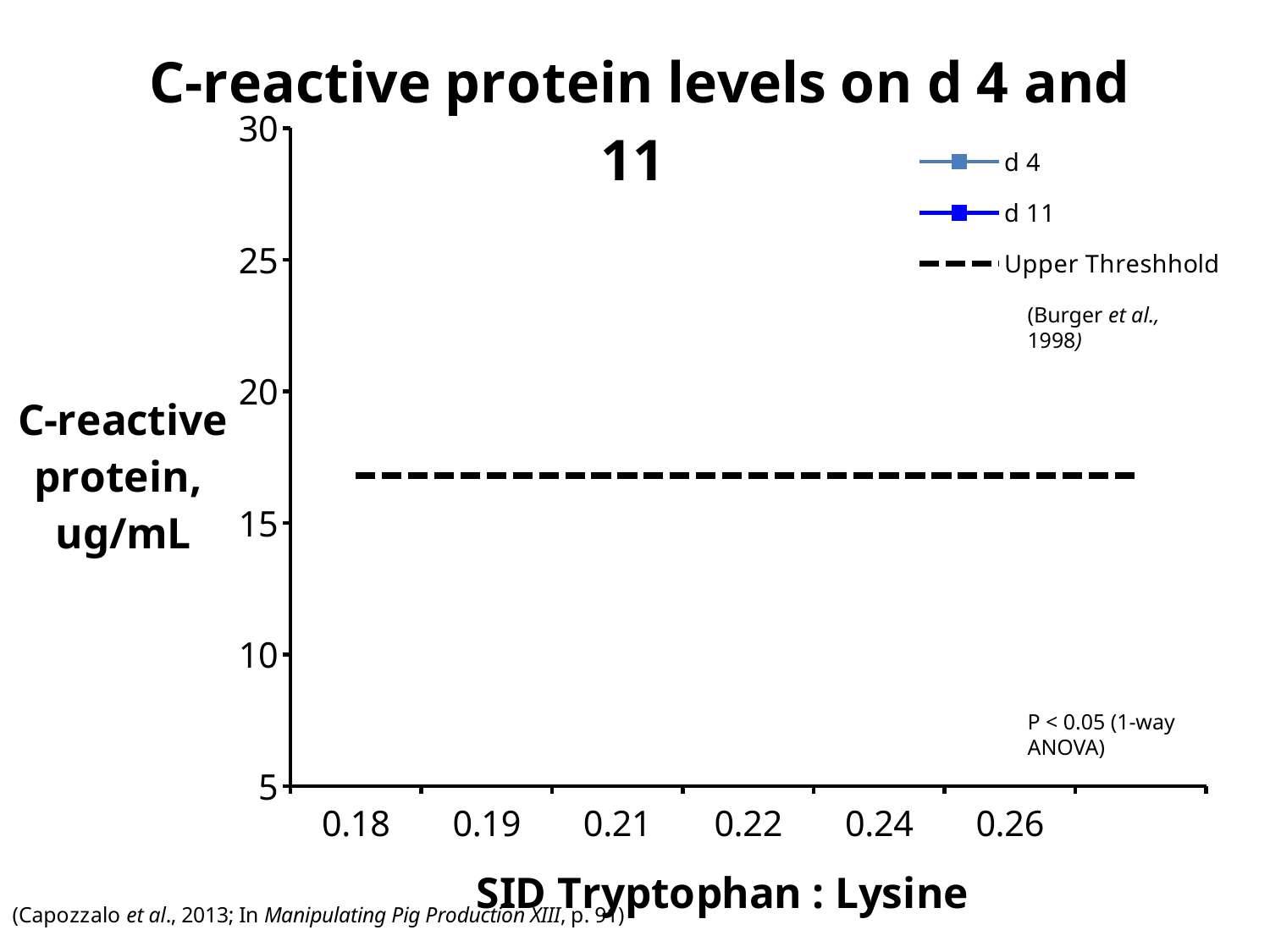
Does the Upper Threshhold line rise, fall, or stay constant across the x axis? stays constant What is the lowest value shown on the y axis? 5 What is the last category on the x axis? 0.26 What is the first category on the x axis? 0.18 What kind of chart is shown on the slide? line chart Is the Upper Threshhold line greater or less than 20 ug/mL? less Is the Upper Threshhold line greater or less than 15 ug/mL? greater What is the highest value shown on the y axis? 30 What is the title of the chart? C-reactive protein levels on d 4 and 11 How many series does the legend list? 3 What is the label of the x axis? SID Tryptophan : Lysine How many SID Tryptophan : Lysine categories are shown on the x axis? 6